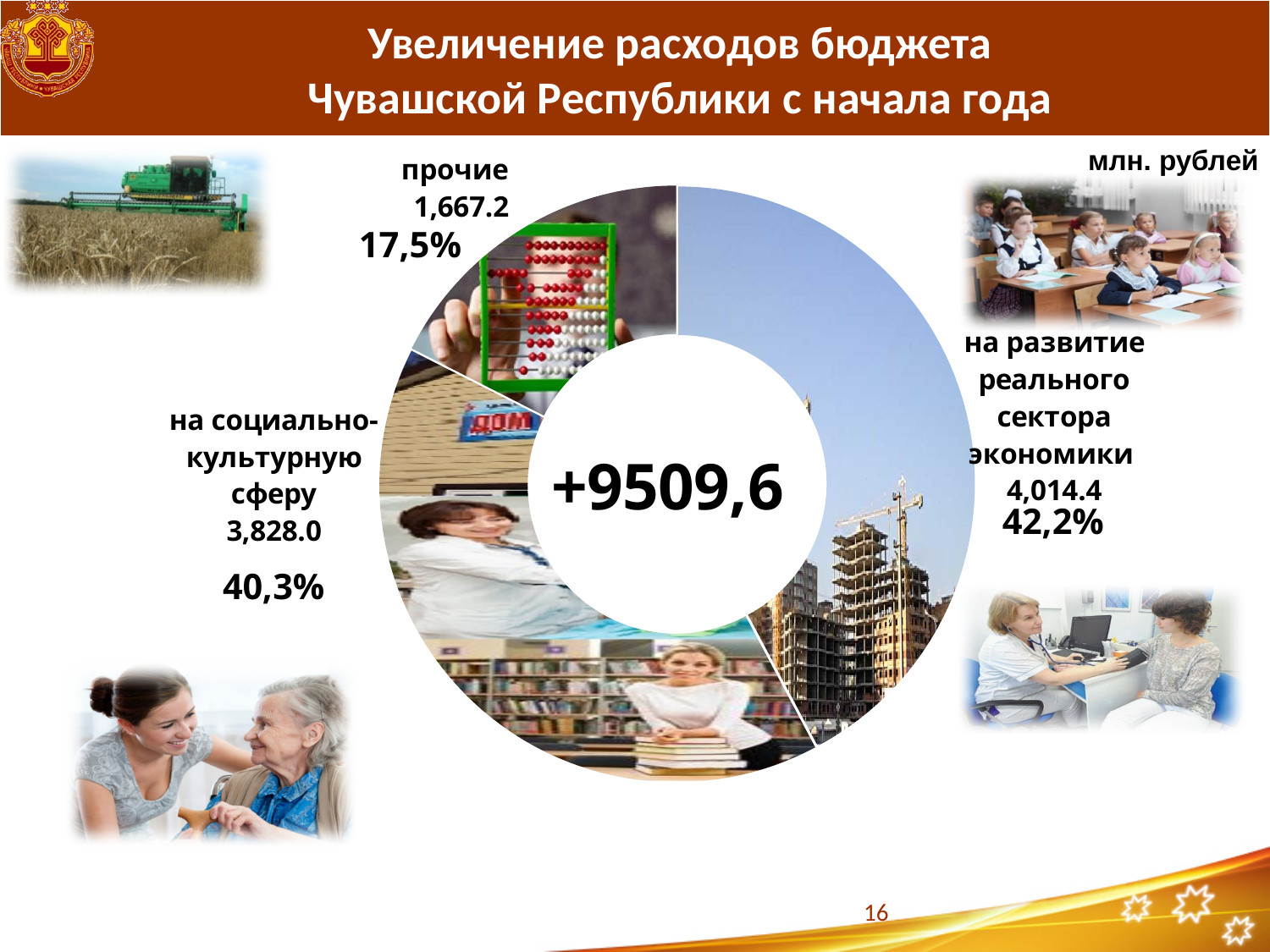
What is the difference between the values for "на развитие реального сектора экономики" and "на социально-культурную сферу"? 186.4 Which segment has the smallest value? прочие What percentage is shown for the segment "на социально-культурную сферу"? 40,3% What value is shown for the segment "на развитие реального сектора экономики"? 4,014.4 In what units are the chart values given? млн. рублей What percentage is shown for the segment "прочие"? 17,5% How many segments does the doughnut chart have? 3 Which segment has the largest value? на развитие реального сектора экономики What total figure is shown in the centre of the doughnut chart? +9509,6 Which is larger: the value for "на социально-культурную сферу" or the value for "прочие"? на социально-культурную сферу What kind of chart is shown on the slide? doughnut chart What value is shown for the segment "прочие"? 1,667.2